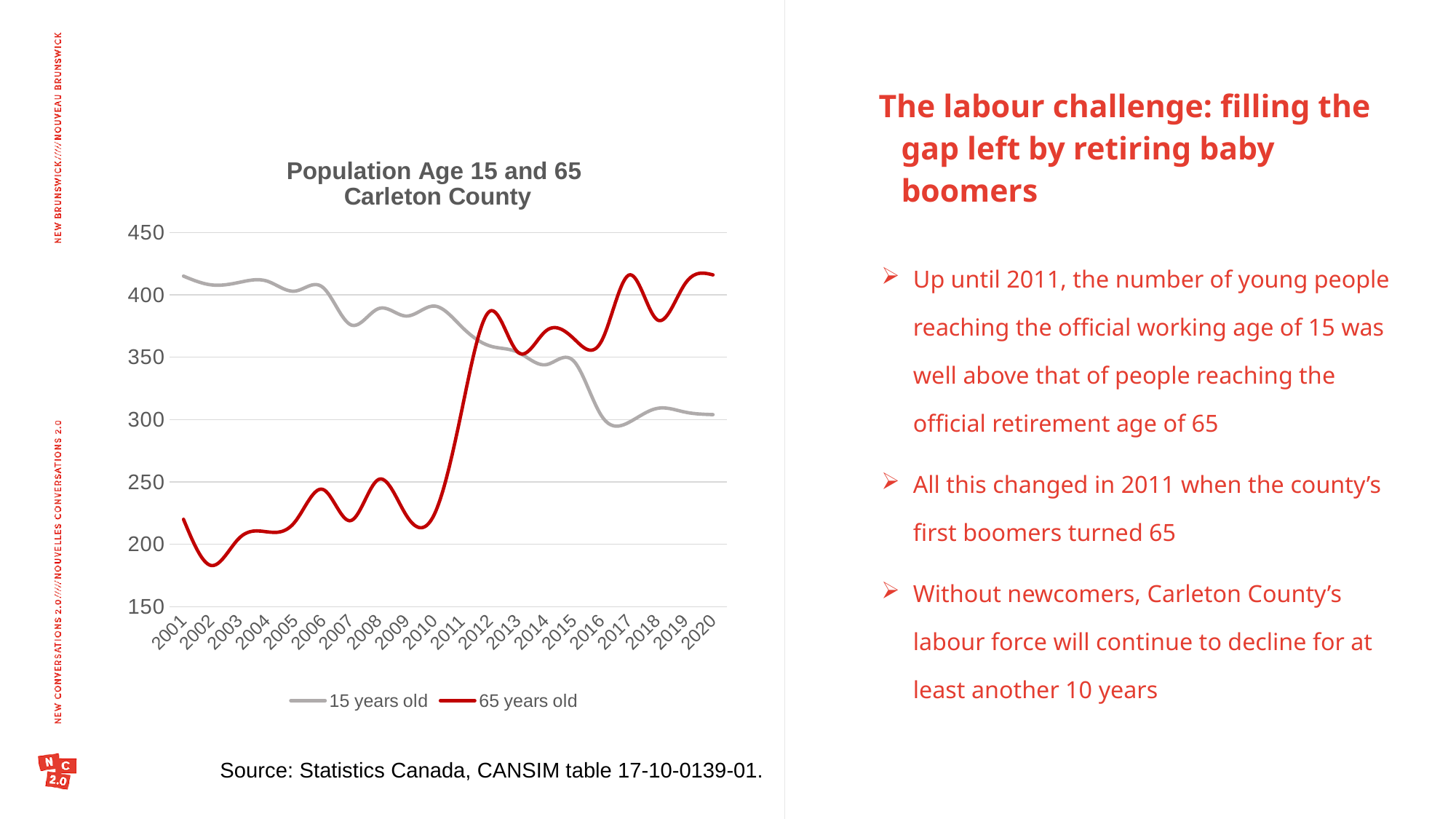
What kind of chart is shown on the slide? line chart What is the title of the chart? Population Age 15 and 65 Carleton County In 2020, which series has the larger value, 15 years old or 65 years old? 65 years old Overall, does the 15 years old series rise or fall from 2001 to 2020? fall Is the value for 65 years old in 2002 greater or less than 200? less In 2005, which series has the larger value, 15 years old or 65 years old? 15 years old Which colour is used for the 65 years old series? red Overall, does the 65 years old series rise or fall from 2001 to 2020? rise Is the value for 65 years old in 2010 greater or less than 250? less How many years are plotted along the x axis? 20 Is the value for 15 years old in 2001 greater or less than 400? greater How many series does the legend list? 2